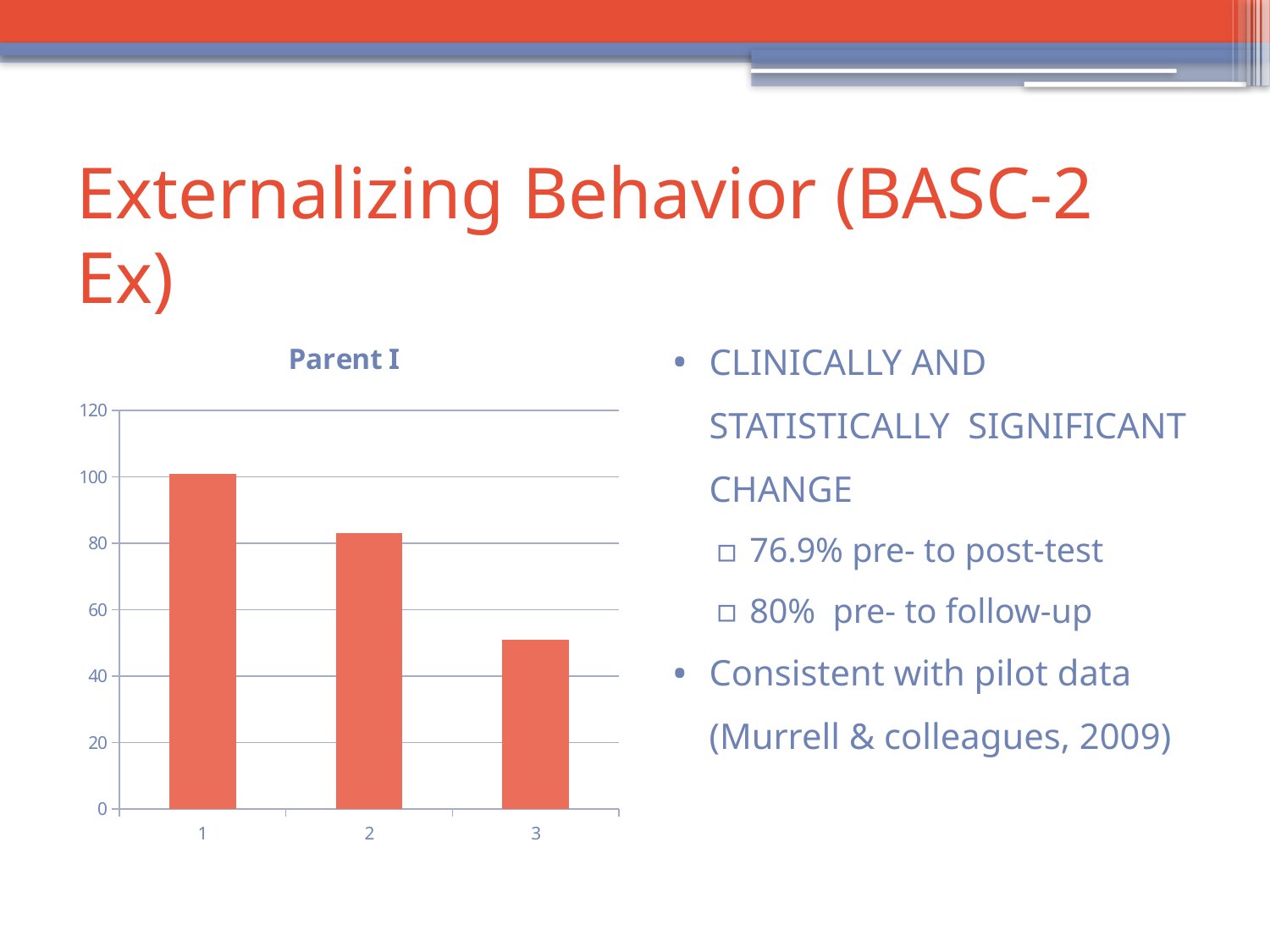
What is the title of the chart? Parent I Which category has the highest bar? 1 Which category has the lowest bar? 3 Do the values rise or fall from category 1 to category 3? fall What kind of chart is shown on the slide? bar chart Which is larger, the value for category 2 or category 3? 2 How many bars are plotted in the chart? 3 Is the value for category 2 greater or less than 80? greater Which is larger, the value for category 1 or category 2? 1 What is the highest value shown on the vertical axis? 120 Is the value for category 3 greater or less than 60? less